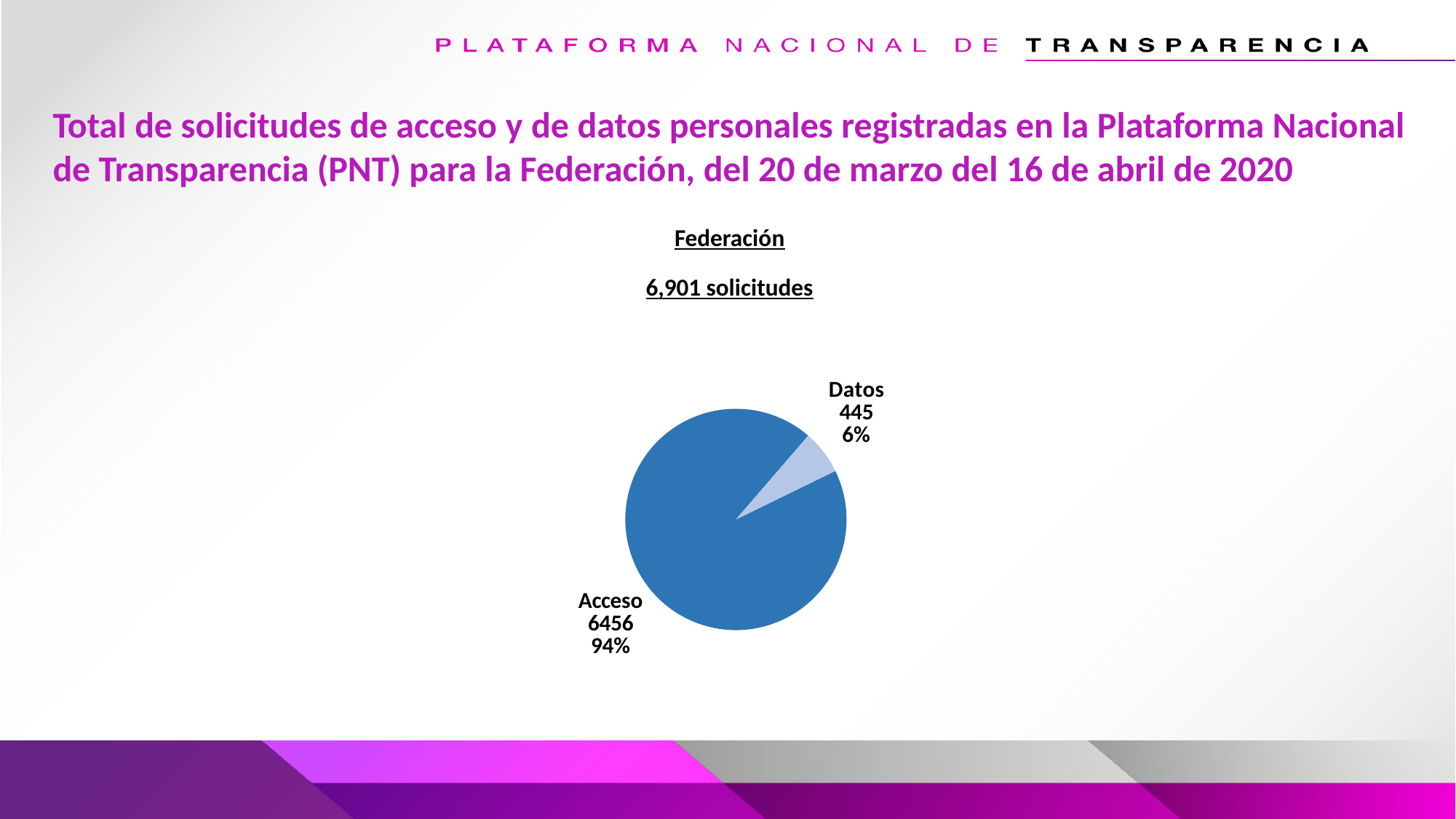
How many slices does the pie chart have? 2 What is the value for Acceso in the pie chart? 6456 What kind of chart is shown on the slide? pie chart What total number of solicitudes is stated above the pie chart? 6,901 solicitudes What is the value for Datos in the pie chart? 445 What is the heading shown directly above the pie chart? Federación What share of the pie does the Datos slice represent? 6% Which is larger, the value for Acceso or the value for Datos? Acceso What is the difference between the Acceso and Datos values? 6011 Which slice of the pie chart is the largest? Acceso What share of the pie does the Acceso slice represent? 94% Which slice of the pie chart is the smallest? Datos